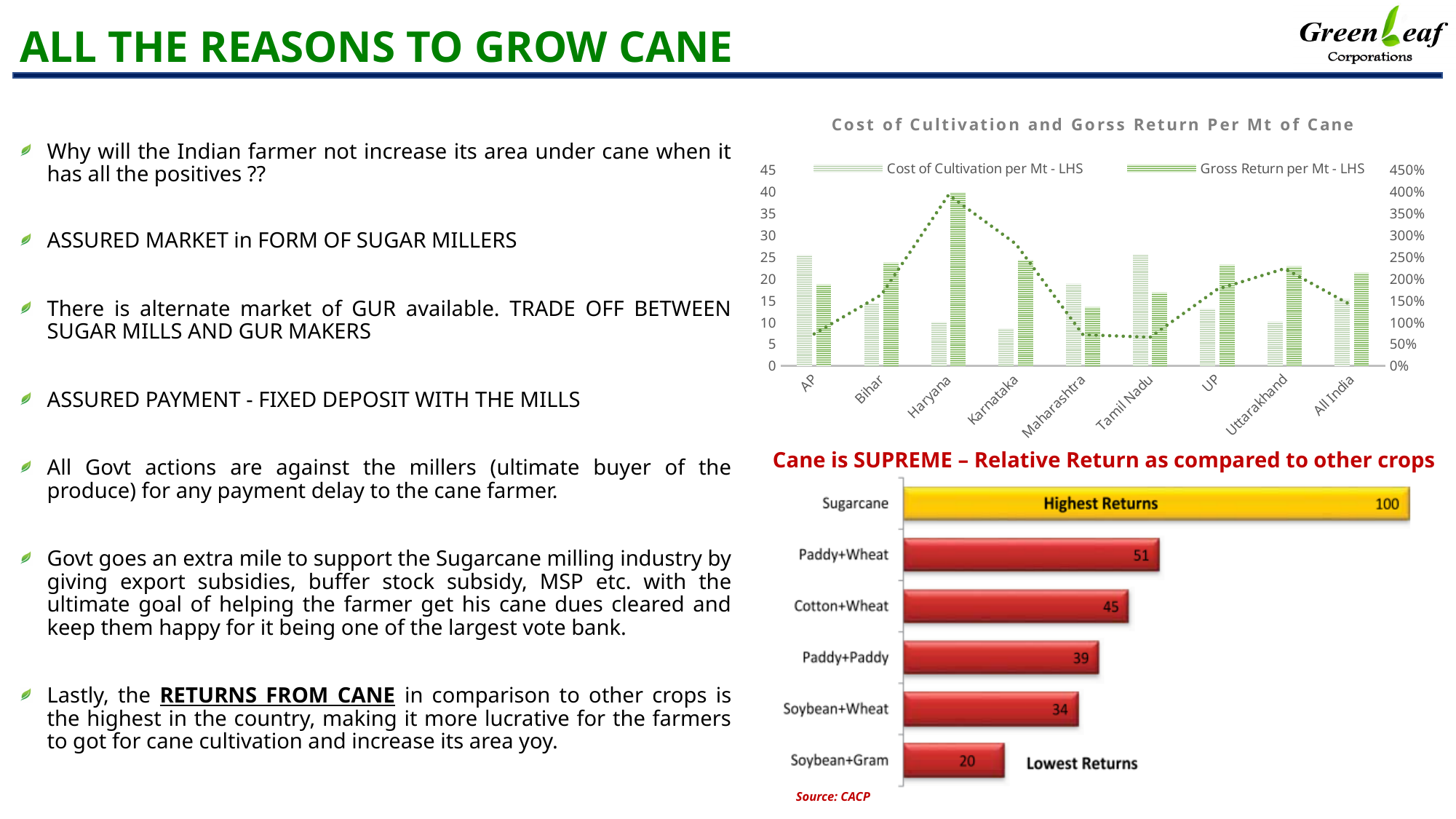
How many crop categories are shown in the 'Cane is SUPREME' chart? 6 In the 'Cane is SUPREME' chart, which crop has the highest relative return? Sugarcane In the 'Cost of Cultivation and Gorss Return Per Mt of Cane' chart, is the Cost of Cultivation per Mt for Karnataka greater or less than 10? less In the 'Cane is SUPREME' chart, which is larger: Cotton+Wheat or Paddy+Paddy? Cotton+Wheat How many series does the legend of the 'Cost of Cultivation and Gorss Return Per Mt of Cane' chart list? 2 In the 'Cane is SUPREME' chart, which crop has the lowest relative return? Soybean+Gram In the 'Cane is SUPREME' chart, what is the value for Paddy+Wheat? 51 In the 'Cost of Cultivation and Gorss Return Per Mt of Cane' chart, which state has the highest Gross Return per Mt bar? Haryana How many states/regions are shown on the x axis of the 'Cost of Cultivation and Gorss Return Per Mt of Cane' chart? 9 In the 'Cane is SUPREME' chart, what is the difference between the values for Sugarcane and Paddy+Wheat? 49 In the 'Cane is SUPREME' chart, what is the value for Soybean+Gram? 20 What kind of chart is the 'Cane is SUPREME' chart? Bar chart